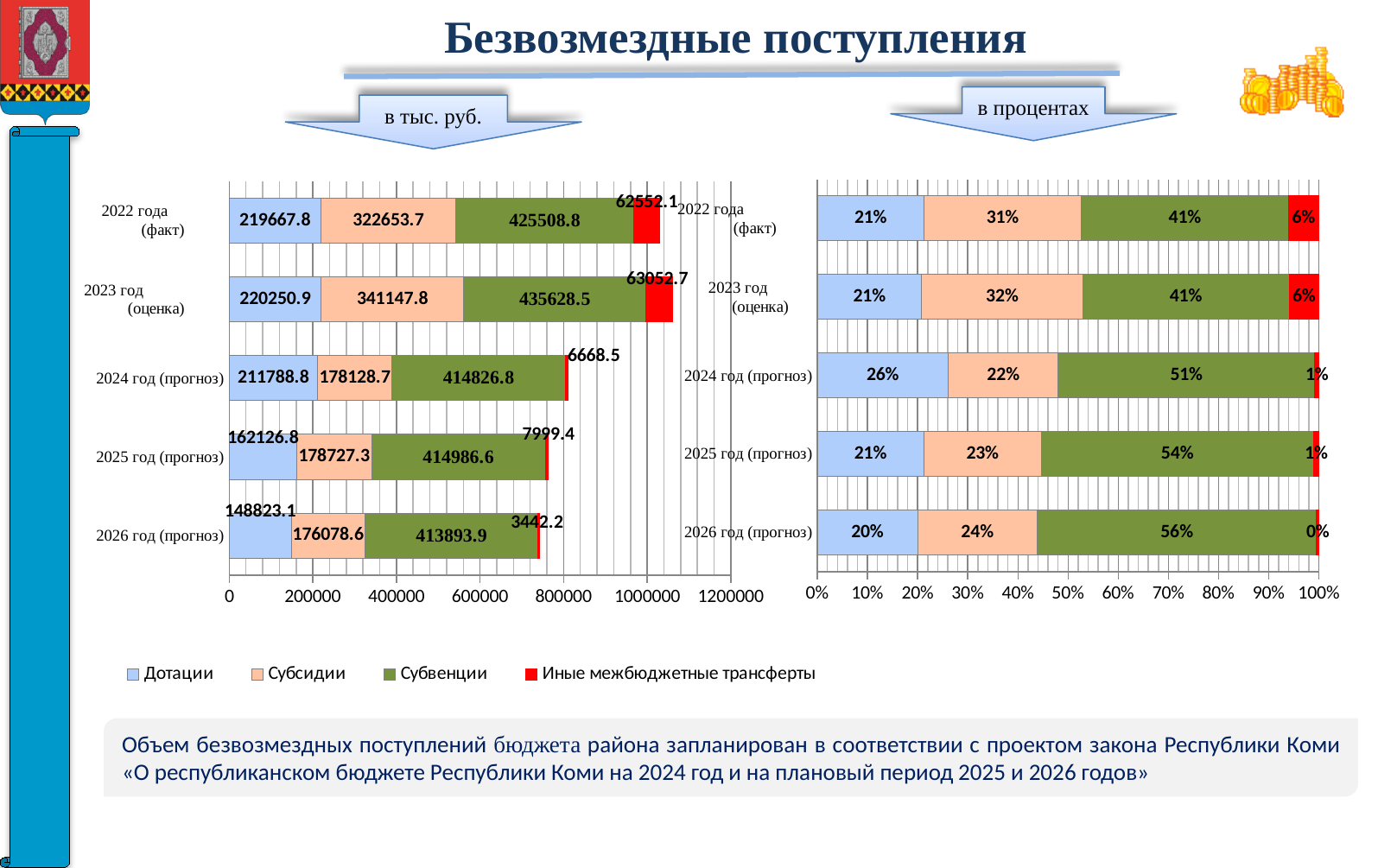
In the right chart (в процентах), what share do Субвенции have in 2025 год (прогноз)? 54% In the left chart (в тыс. руб.), what is the value of Субвенции for 2023 год (оценка)? 435628.5 In the left chart (в тыс. руб.), which year has the highest value for Субсидии? 2023 год (оценка) How many years (categories) are shown in the right chart (в процентах)? 5 What kind of chart is the left chart (в тыс. руб.)? Stacked bar chart In the left chart (в тыс. руб.), is the total length of the 2026 год (прогноз) bar greater or less than 800000? less How many series does the legend list? 4 In the left chart (в тыс. руб.), which year has the lowest value for Дотации? 2026 год (прогноз) In the left chart (в тыс. руб.), which is larger: Субсидии for 2024 год (прогноз) or Субсидии for 2025 год (прогноз)? 2025 год (прогноз) In the left chart (в тыс. руб.), what is the difference between the Субвенции values for 2023 год (оценка) and 2022 года (факт)? 10119.7 In the left chart (в тыс. руб.), what is the total of the stacked bar for 2024 год (прогноз)? 811412.8 In the left chart (в тыс. руб.), what is the value of Дотации for 2026 год (прогноз)? 148823.1